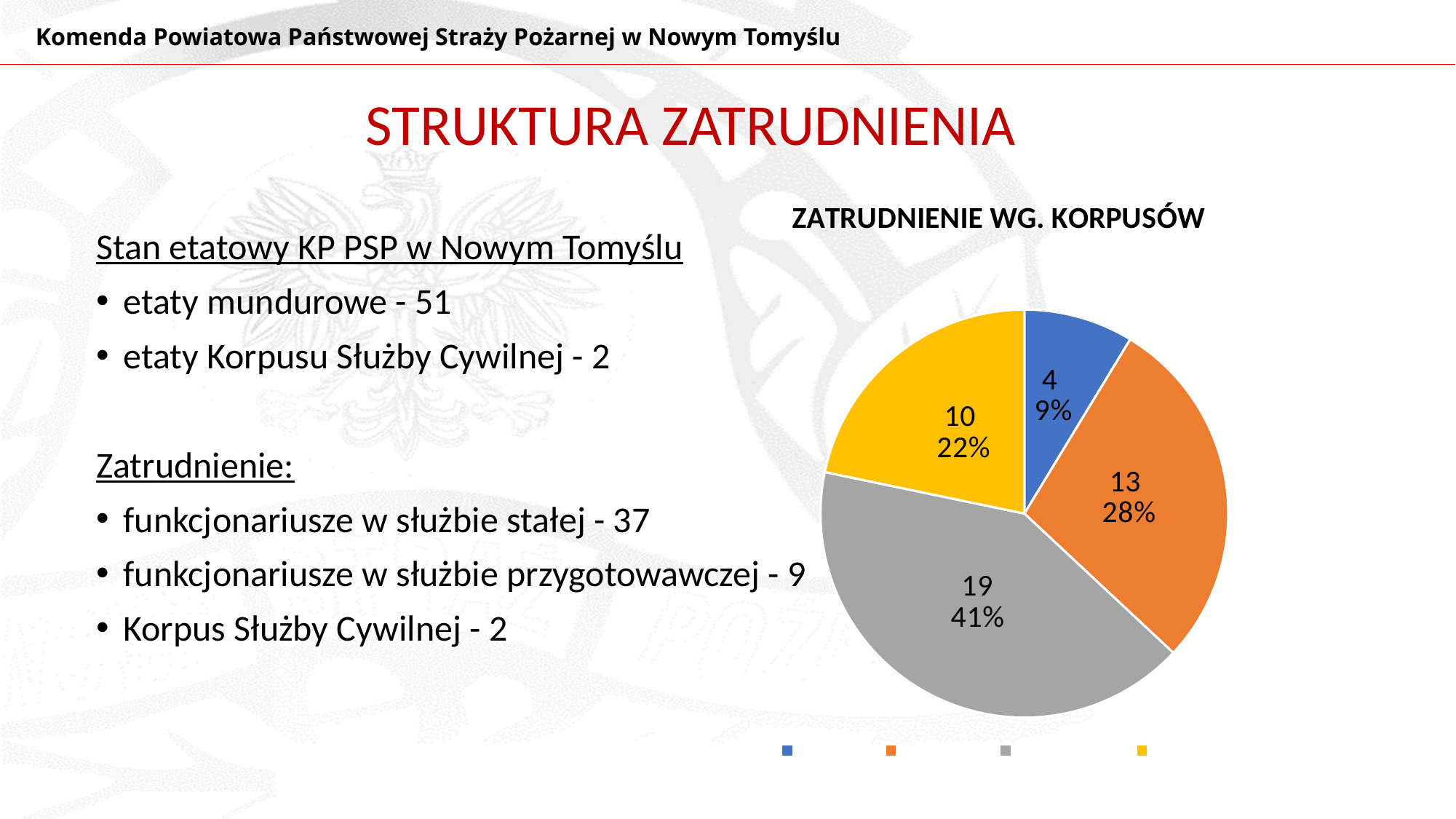
What percentage share does the grey slice of the pie chart have? 41% What is the difference between the values of the grey slice and the orange slice in the pie chart? 6 What value is shown on the grey slice of the pie chart? 19 Which slice has a larger value in the pie chart, the yellow slice or the orange slice? the orange slice What value is shown on the orange slice of the pie chart? 13 What percentage share does the yellow slice of the pie chart have? 22% Which slice of the pie chart is the largest? the grey slice (19, 41%) What kind of chart is shown on the slide? pie chart What value is shown on the blue slice of the pie chart? 4 What is the title of the pie chart? ZATRUDNIENIE WG. KORPUSÓW Which slice of the pie chart is the smallest? the blue slice (4, 9%) How many slices does the pie chart have? 4